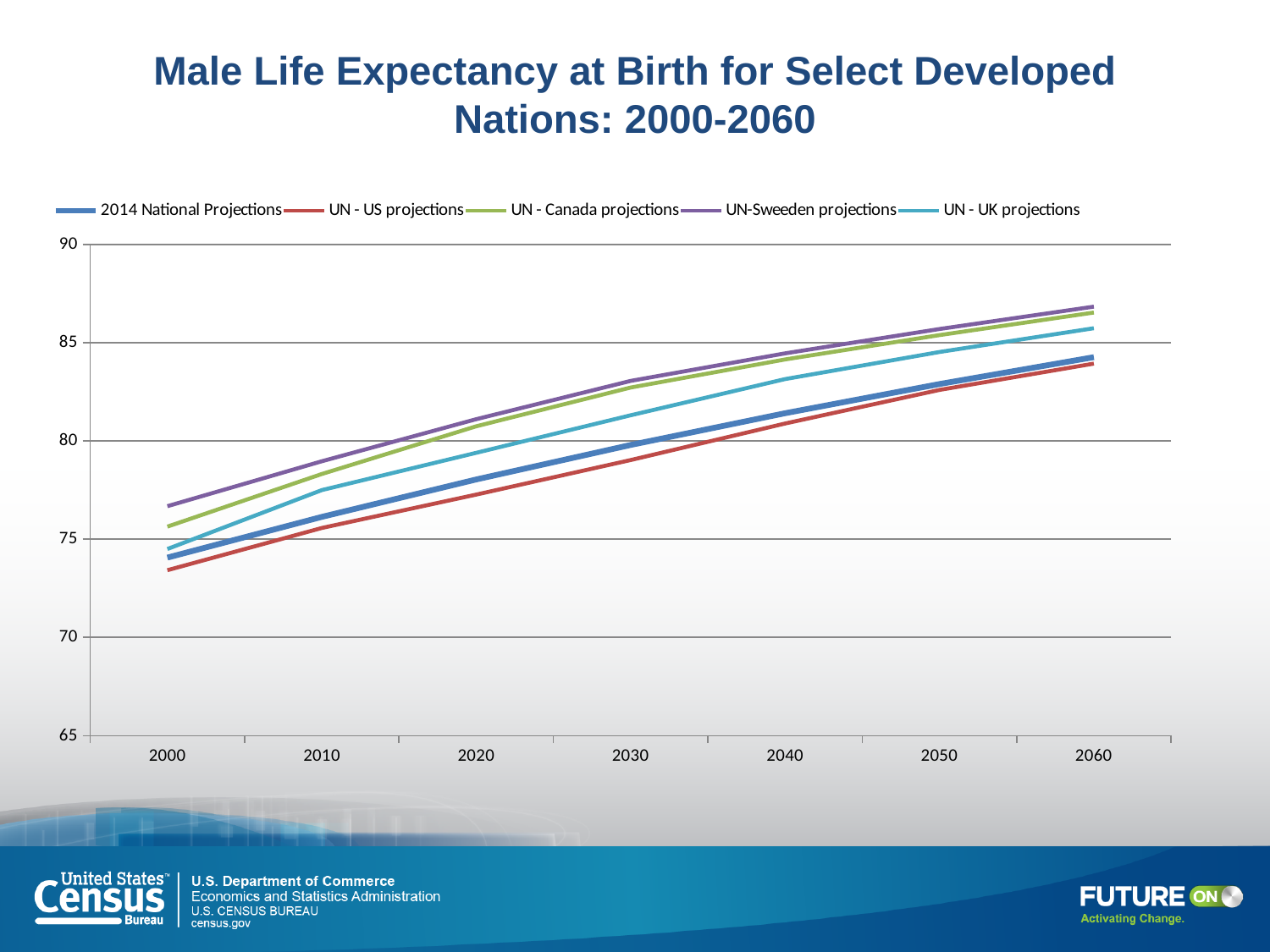
Is the value for UN - US projections in 2000 greater or less than 75? less How many years are labelled along the x axis? 7 What is the title of the chart? Male Life Expectancy at Birth for Select Developed Nations: 2000-2060 Do the values for the UN-Sweeden projections rise or fall from 2000 to 2060? Rise Is the value for UN-Sweeden projections in 2060 greater or less than 85? greater Which series has the lowest value in 2000? UN - US projections Which series has the highest value in 2060? UN-Sweeden projections How many series does the legend list? 5 In 2020, which is higher: UN - Canada projections or UN - UK projections? UN - Canada projections Is the value for 2014 National Projections in 2060 greater or less than 85? less What kind of chart is shown on the slide? Line chart